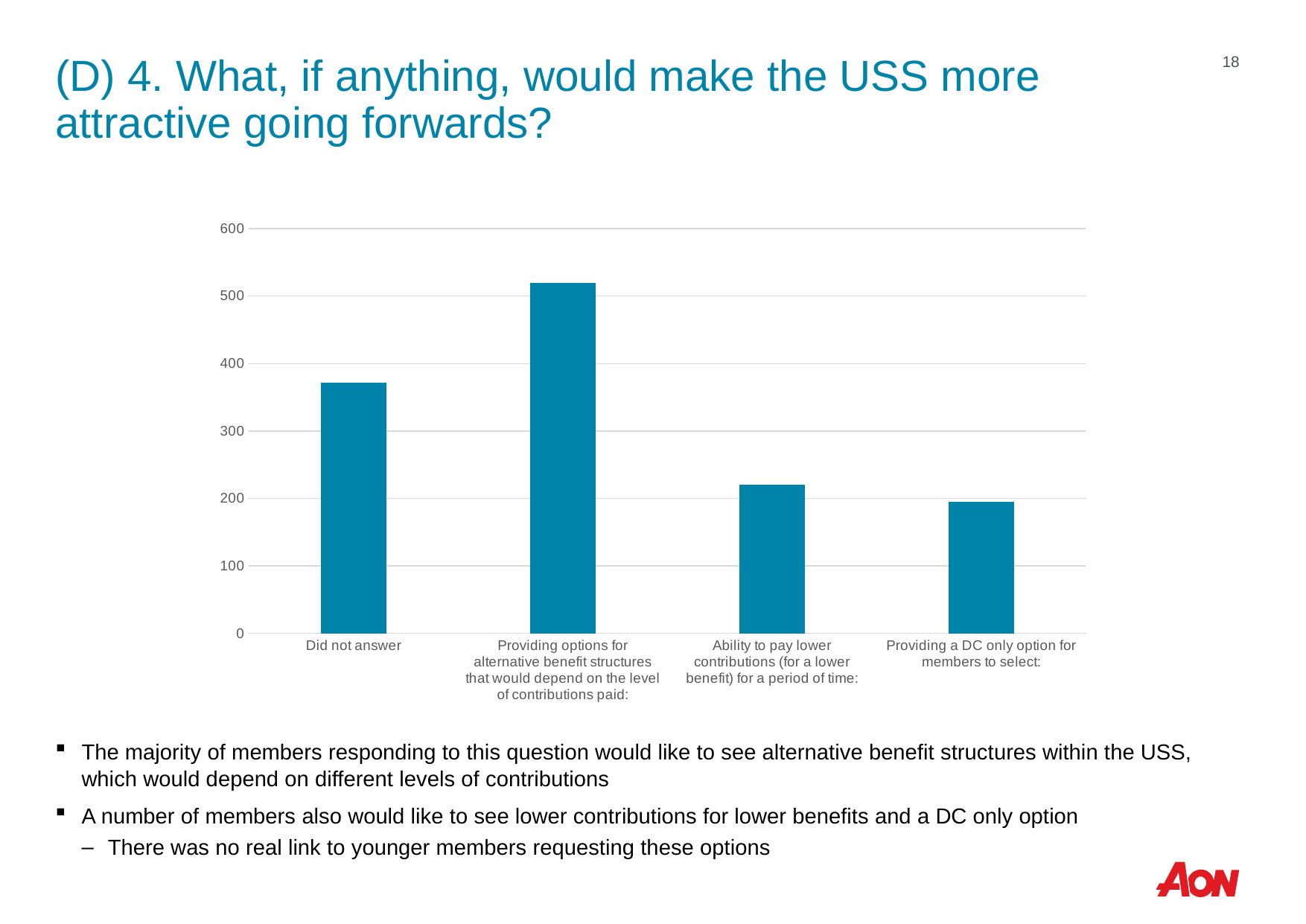
Is the value for "Did not answer" greater or less than 400? less What kind of chart is shown on the slide? bar chart Which is larger: the value for "Did not answer" or the value for "Ability to pay lower contributions (for a lower benefit) for a period of time:"? Did not answer How many categories are shown on the x axis of the chart? 4 Which category has the highest value in the chart? Providing options for alternative benefit structures that would depend on the level of contributions paid: Which category has the lowest value in the chart? Providing a DC only option for members to select: Is the value for "Providing a DC only option for members to select:" greater or less than 100? greater Is the value for "Did not answer" greater or less than 300? greater Which is larger: the value for "Did not answer" or the value for "Providing options for alternative benefit structures that would depend on the level of contributions paid:"? Providing options for alternative benefit structures that would depend on the level of contributions paid: What is the highest value shown on the y axis of the chart? 600